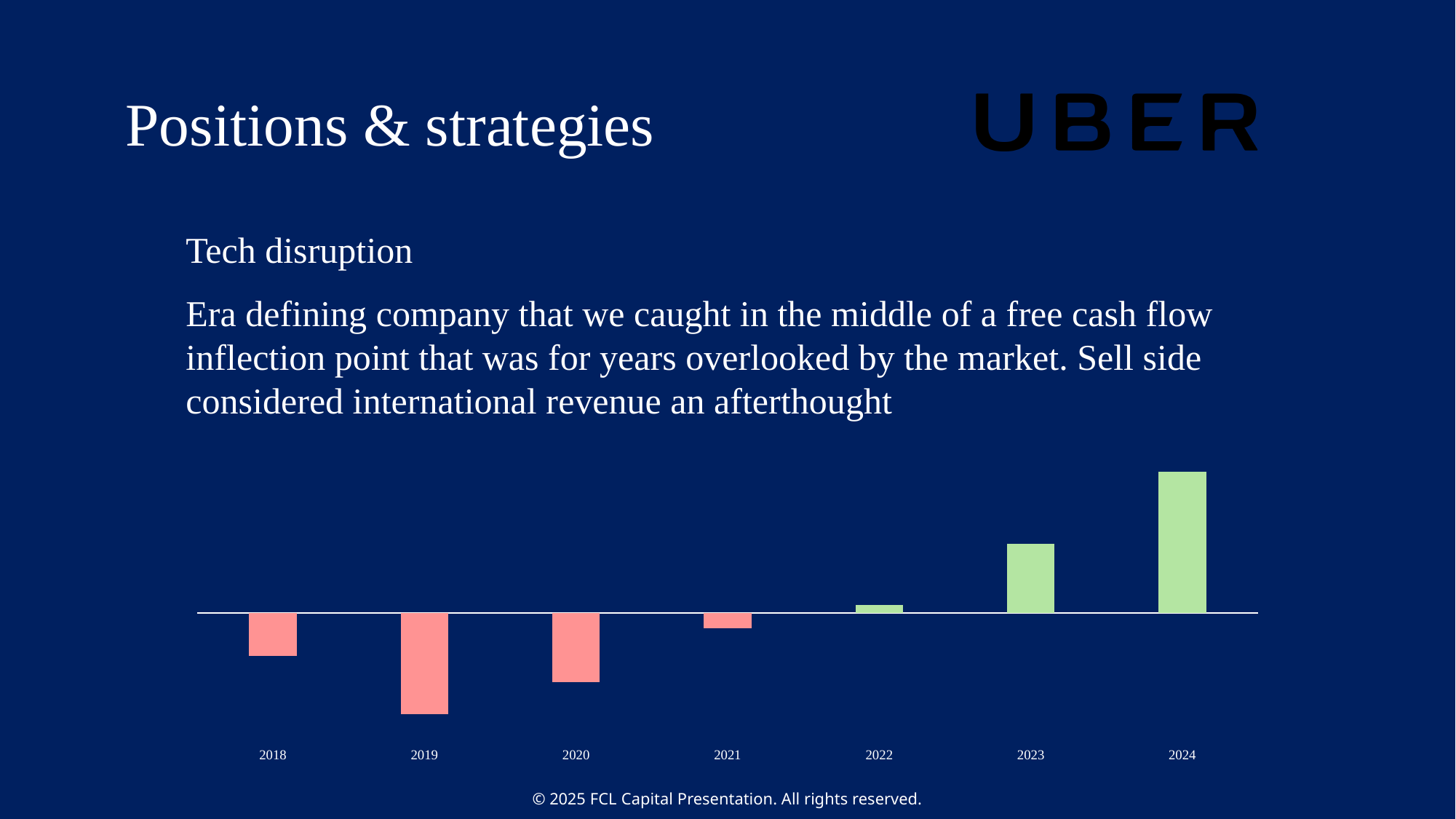
Is the bar for 2018 higher or lower than the bar for 2019? higher Which year has the highest bar in the chart? 2024 How many years are shown on the x axis of the chart? 7 What kind of chart is shown on the slide? bar chart What colour are the bars that fall below the baseline? red Which year has the lowest bar in the chart? 2019 How many years in the chart have bars below the baseline? 4 Is the bar for 2023 higher or lower than the bar for 2022? higher Which is the first year in the chart with a positive (above the baseline) bar? 2022 Do the values generally rise or fall from 2019 to 2024? rise Is the bar for 2024 higher or lower than the bar for 2023? higher